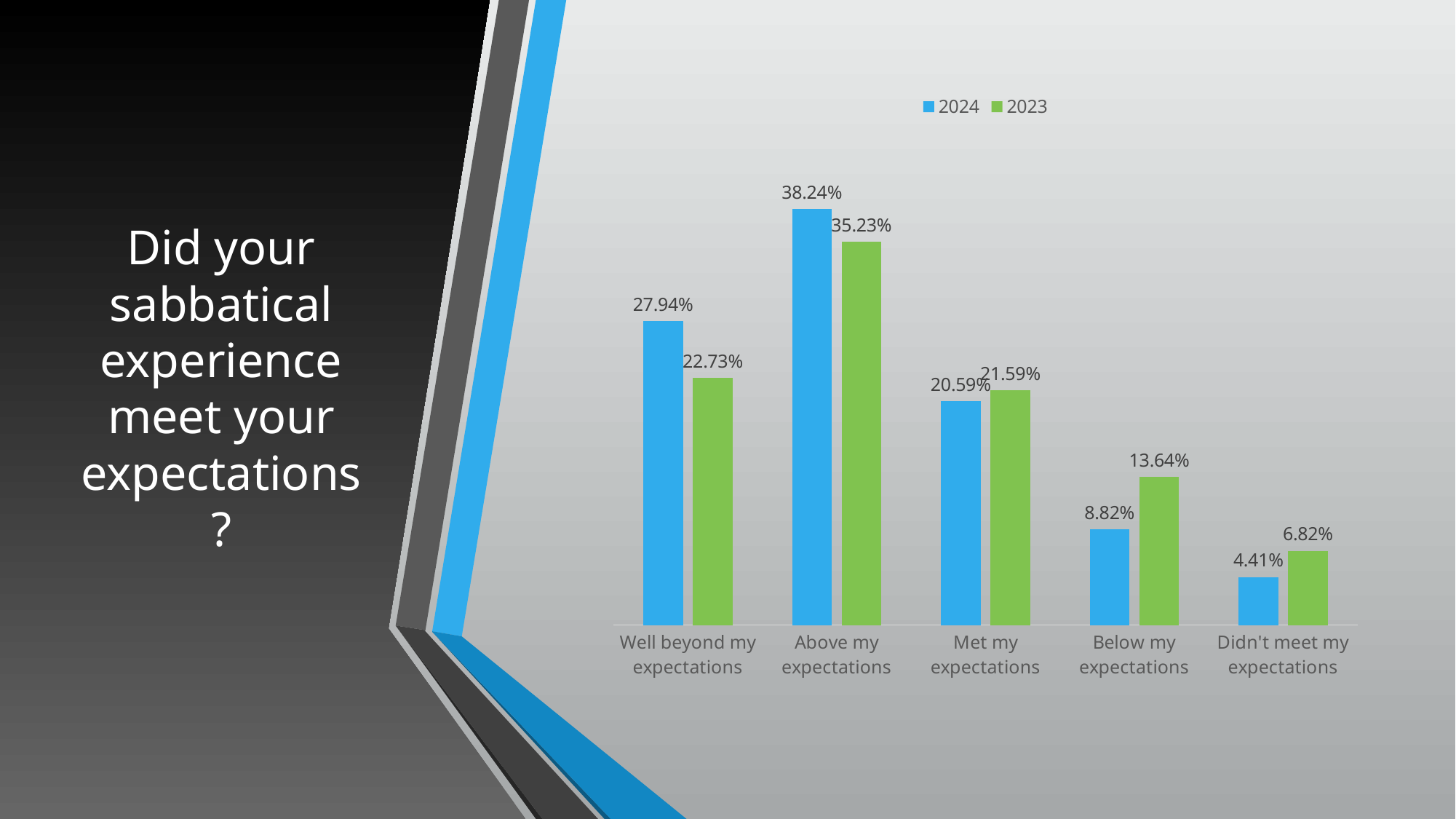
Which is larger for "Met my expectations": the 2024 value or the 2023 value? 2023 What kind of chart is shown on the slide? Bar chart What is the 2024 value for "Above my expectations"? 38.24% Which category has the lowest 2023 value? Didn't meet my expectations Which series is shown in green in the legend? 2023 What is the difference between the 2024 and 2023 values for "Well beyond my expectations"? 5.21% How many categories are shown on the x axis? 5 How many series does the legend list? 2 Which category has the highest 2024 value? Above my expectations What is the 2024 value for "Didn't meet my expectations"? 4.41% What is the 2023 value for "Well beyond my expectations"? 22.73% What is the 2023 value for "Below my expectations"? 13.64%